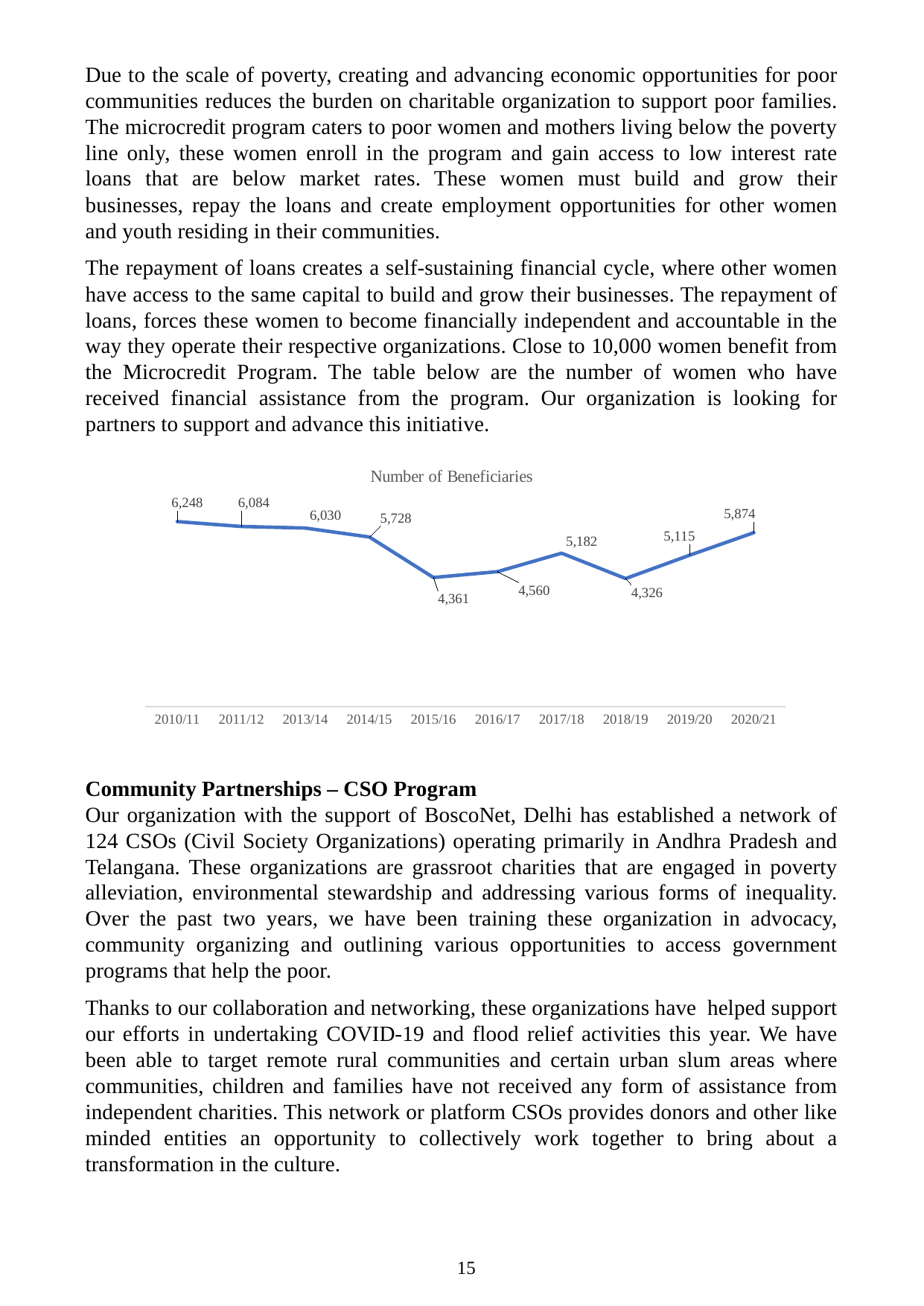
Does the number of beneficiaries rise or fall from 2010/11 to 2015/16? Fall How many years are plotted on the chart? 10 What is the difference in the number of beneficiaries between 2017/18 and 2018/19? 856 What is the difference in the number of beneficiaries between 2010/11 and 2020/21? 374 What kind of chart is shown? Line chart What is the number of beneficiaries for 2020/21? 5,874 Which year has the lowest number of beneficiaries? 2018/19 What is the number of beneficiaries for 2015/16? 4,361 What is the number of beneficiaries for 2010/11? 6,248 Which year has more beneficiaries, 2016/17 or 2019/20? 2019/20 What is the title of the chart? Number of Beneficiaries Which year has the highest number of beneficiaries? 2010/11